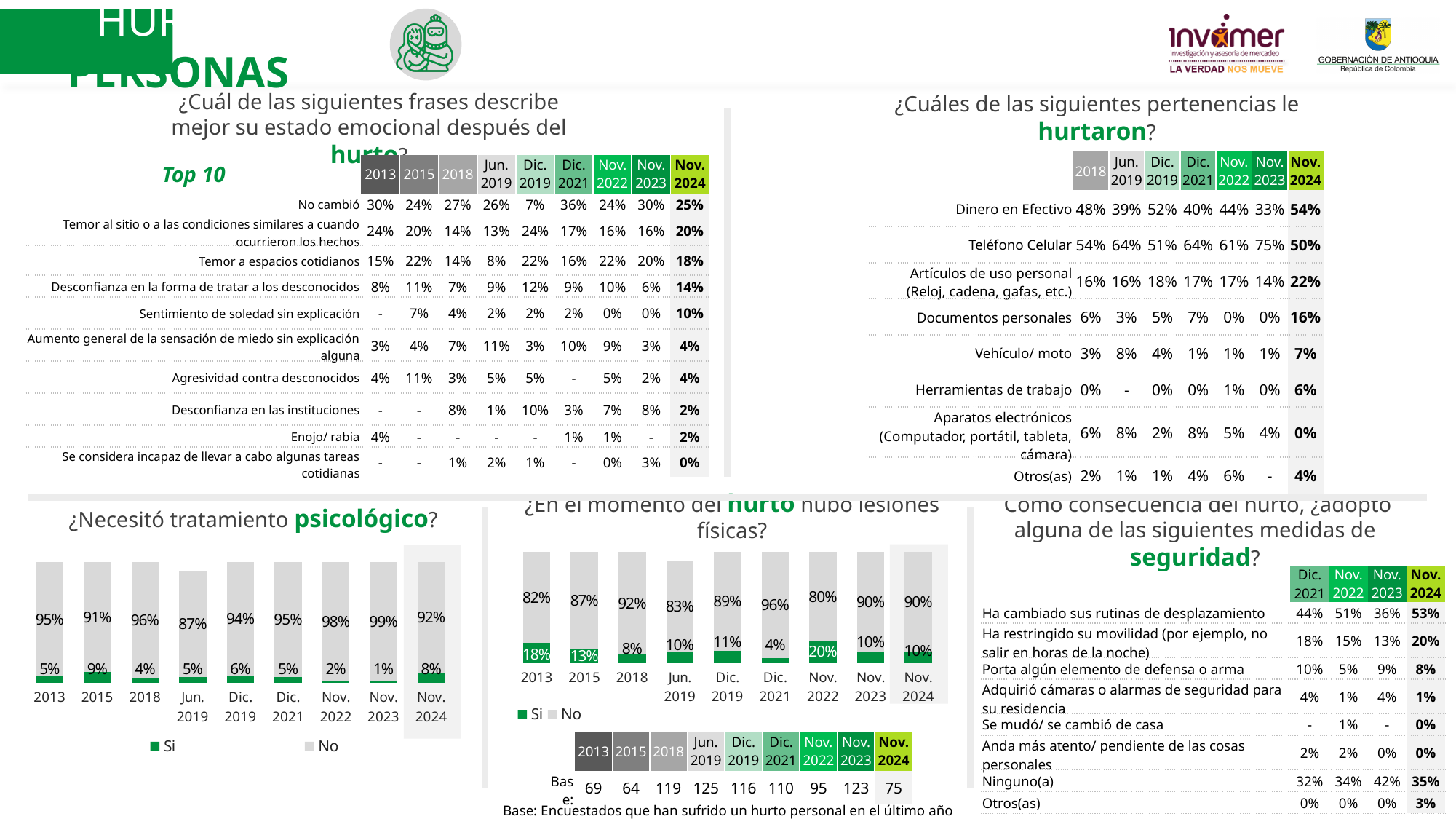
What type of chart is '¿En el momento del hurto hubo lesiones físicas?'? Stacked bar chart In the chart '¿En el momento del hurto hubo lesiones físicas?', what is the difference between the 'Sí' values for 2013 and 2015? 5% In the chart '¿En el momento del hurto hubo lesiones físicas?', what is the 'Sí' value for Nov. 2022? 20% In the chart '¿Necesitó tratamiento psicológico?', which period has the lowest 'Sí' value? Nov. 2023 In the chart '¿Necesitó tratamiento psicológico?', what is the 'Sí' value for Nov. 2024? 8% In the chart '¿Necesitó tratamiento psicológico?', which period has the highest 'Sí' value? 2015 In the chart '¿Necesitó tratamiento psicológico?', how many periods are shown on the x axis? 9 In the chart '¿En el momento del hurto hubo lesiones físicas?', which period has the lowest 'Sí' value? Dic. 2021 In the chart '¿Necesitó tratamiento psicológico?', how many series does the legend list? 2 In the chart '¿En el momento del hurto hubo lesiones físicas?', is the 'Sí' value larger for 2013 or for Nov. 2024? 2013 In the chart '¿Necesitó tratamiento psicológico?', what is the 'No' value for 2015? 91% In the chart '¿En el momento del hurto hubo lesiones físicas?', what is the 'No' value for Dic. 2021? 96%